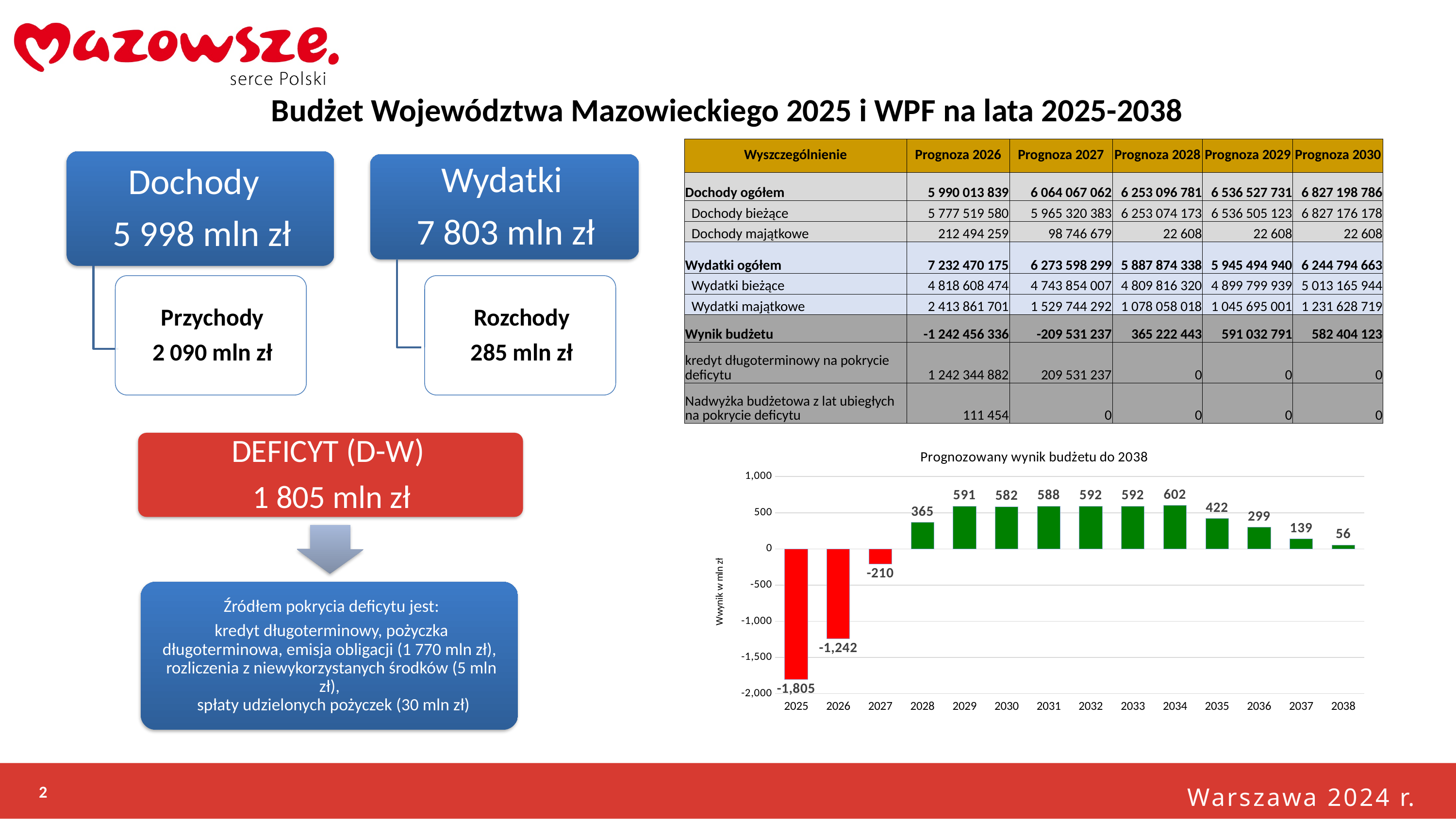
What kind of chart is "Prognozowany wynik budżetu do 2038"? bar chart In the chart "Prognozowany wynik budżetu do 2038", is the value for 2026 greater or less than -1,000? less In the chart "Prognozowany wynik budżetu do 2038", what colour are the bars with negative values? red Which year has the highest value in the chart "Prognozowany wynik budżetu do 2038"? 2034 In the chart "Prognozowany wynik budżetu do 2038", do the values rise or fall from 2034 to 2038? fall In the chart "Prognozowany wynik budżetu do 2038", which is larger: the value for 2029 or the value for 2030? 2029 Which year has the lowest value in the chart "Prognozowany wynik budżetu do 2038"? 2025 What is the value for 2034 in the chart "Prognozowany wynik budżetu do 2038"? 602 In the chart "Prognozowany wynik budżetu do 2038", what is the difference between the values for 2035 and 2036? 123 What is the value for 2038 in the chart "Prognozowany wynik budżetu do 2038"? 56 How many years are shown on the x axis of the chart "Prognozowany wynik budżetu do 2038"? 14 What is the value for 2025 in the chart "Prognozowany wynik budżetu do 2038"? -1,805